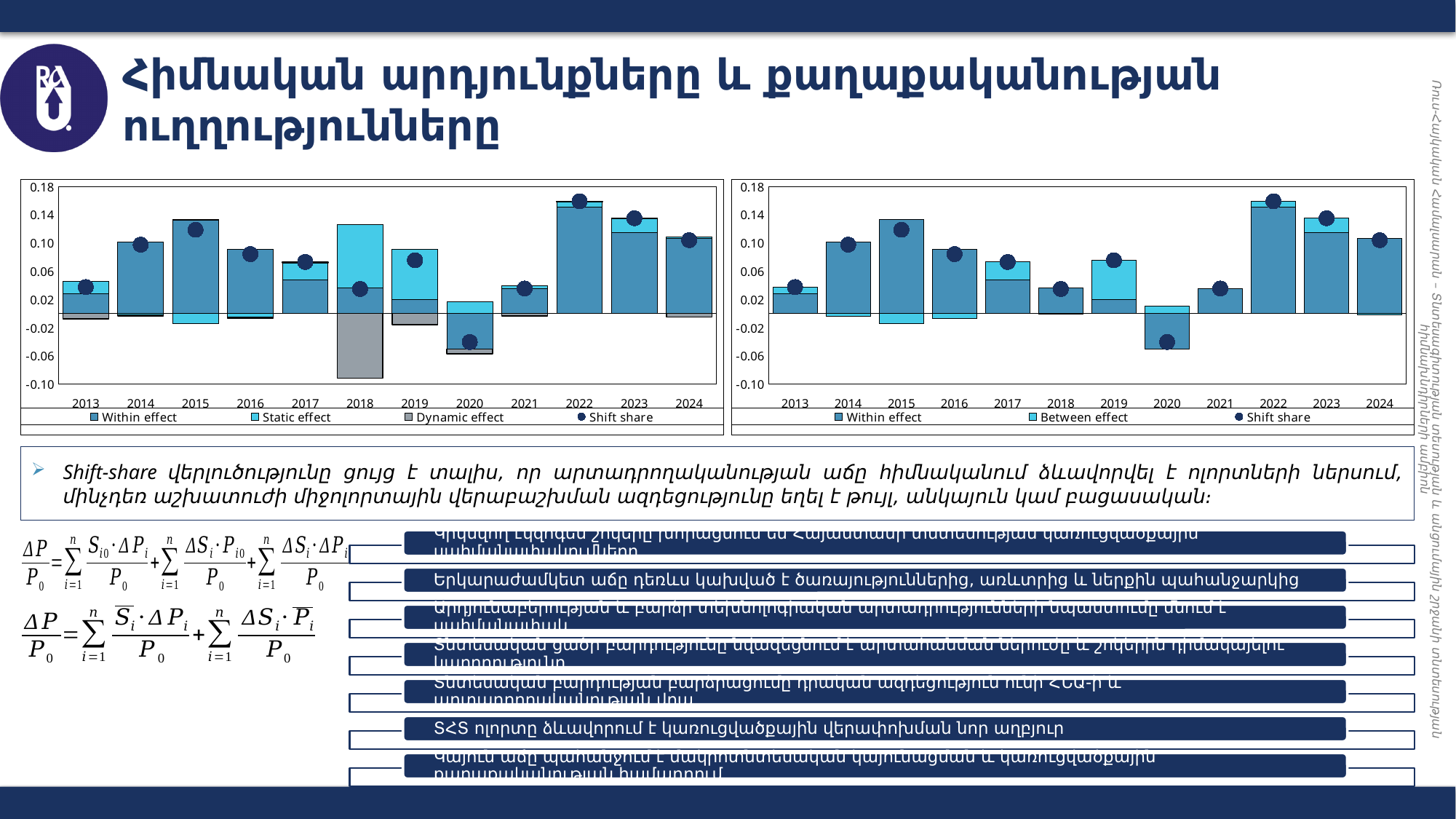
In the right chart, is the Shift share value for 2022 greater or less than 0.14? greater Which series appears in the right chart's legend but not in the left chart's legend? Between effect In the left chart, which legend entry is shown in grey? Dynamic effect In the left chart, how many series does the legend list? 4 In the right chart, which is larger, the Shift share value for 2015 or for 2016? 2015 In the left chart, is the Shift share value for 2020 greater or less than -0.02? less In the right chart, which year has the lowest Shift share value? 2020 What kind of chart is the right chart? Stacked bar chart with a Shift share point series In the right chart, how many series does the legend list? 3 In the left chart, is the Dynamic effect value for 2018 greater or less than -0.06? less In the left chart, how many years are shown on the x axis? 12 In the left chart, which year has the highest Shift share value? 2022